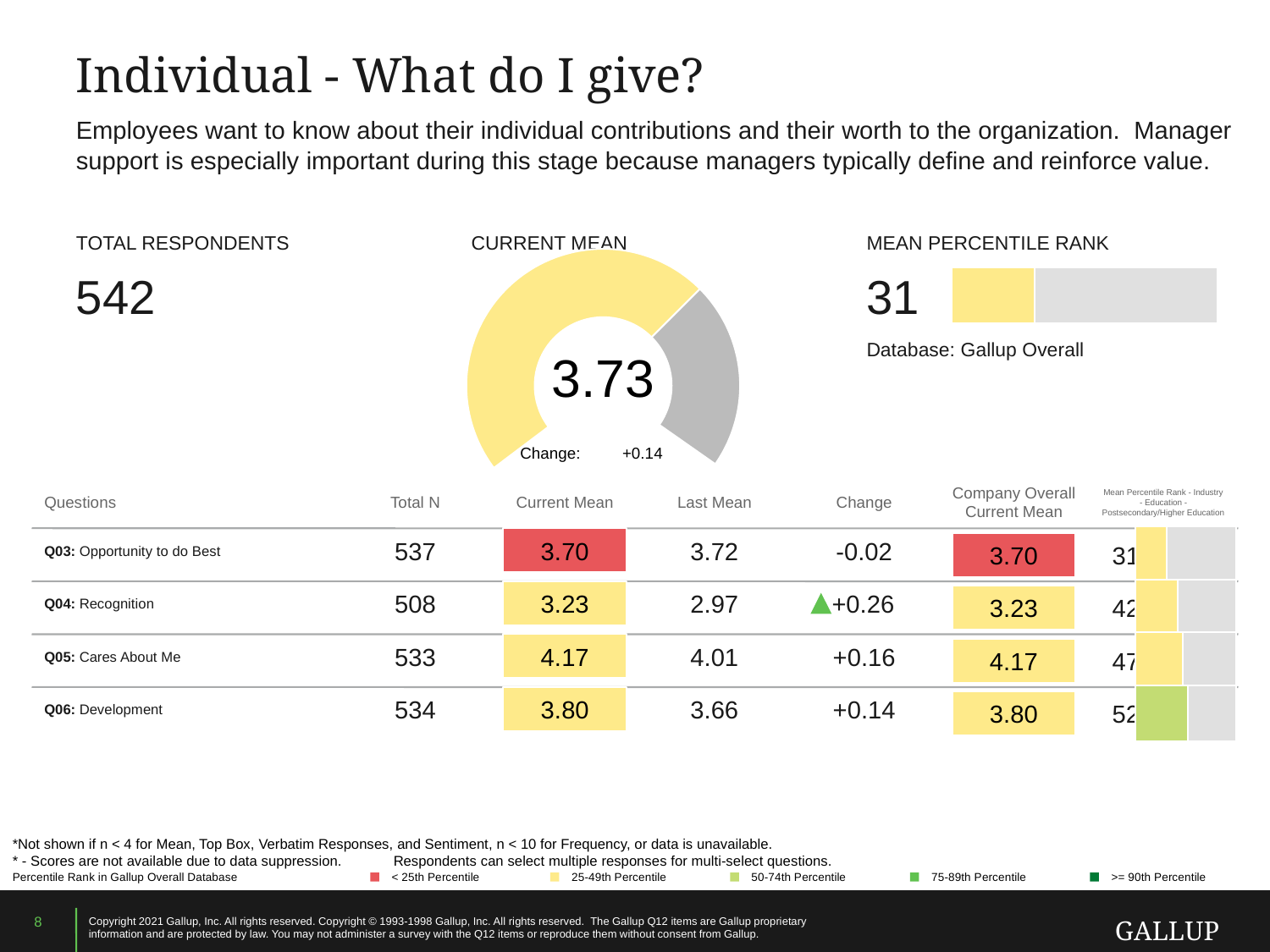
What kind of chart is used to show the CURRENT MEAN of 3.73? Gauge chart What colour is the Current Mean cell for Q03: Opportunity to do Best? Red What is the MEAN PERCENTILE RANK value shown next to the percentile bar? 31 What value does the CURRENT MEAN gauge chart display? 3.73 In the table's Mean Percentile Rank column, which question has the highest percentile rank? Q06: Development Which database is the MEAN PERCENTILE RANK bar compared against? Gallup Overall What change is shown beneath the CURRENT MEAN gauge chart? +0.14 In the table's Mean Percentile Rank column, which question has the lowest percentile rank? Q03: Opportunity to do Best Which has the larger Current Mean in the table, Q05: Cares About Me or Q06: Development? Q05: Cares About Me In the table's Mean Percentile Rank column, what is the percentile rank for Q06: Development? 52 What is the difference between the Mean Percentile Rank of Q06: Development and Q03: Opportunity to do Best? 21 How many questions are listed in the table with percentile rank bars? 4